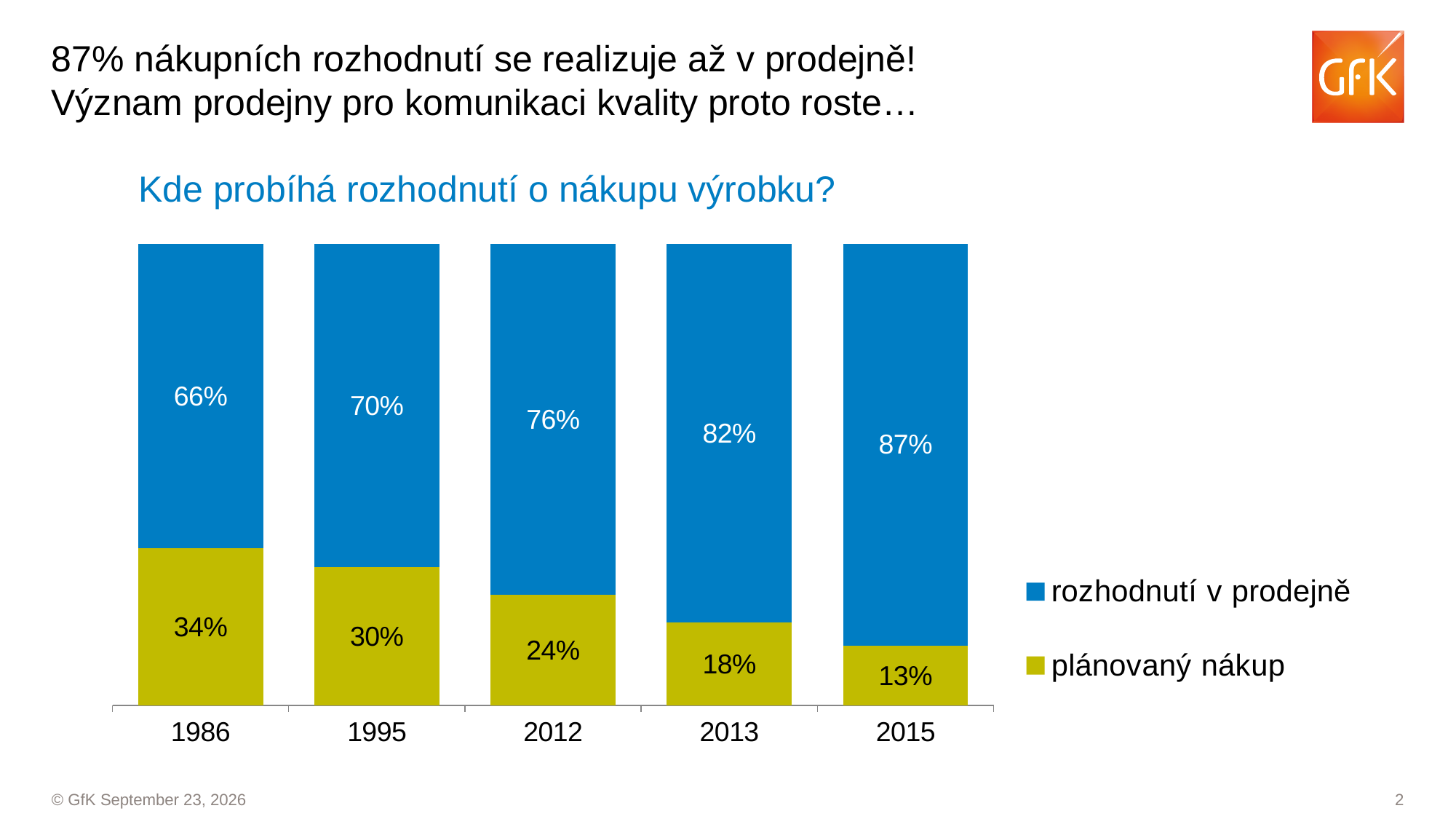
How many years are shown on the x axis? 5 How many series does the legend list? 2 What is the title of the chart? Kde probíhá rozhodnutí o nákupu výrobku? Which year has the lowest value for "rozhodnutí v prodejně"? 1986 What is the difference between the "rozhodnutí v prodejně" values for 2015 and 1986? 21 percentage points What is the value for "rozhodnutí v prodejně" in 2015? 87% Does the value for "plánovaný nákup" rise or fall from 1986 to 2015? Fall Which year has the highest value for "plánovaný nákup"? 1986 Which is larger: "plánovaný nákup" in 1995 or in 2013? 1995 What is the value for "rozhodnutí v prodejně" in 2012? 76% What kind of chart is shown? Stacked bar chart What is the value for "plánovaný nákup" in 1986? 34%